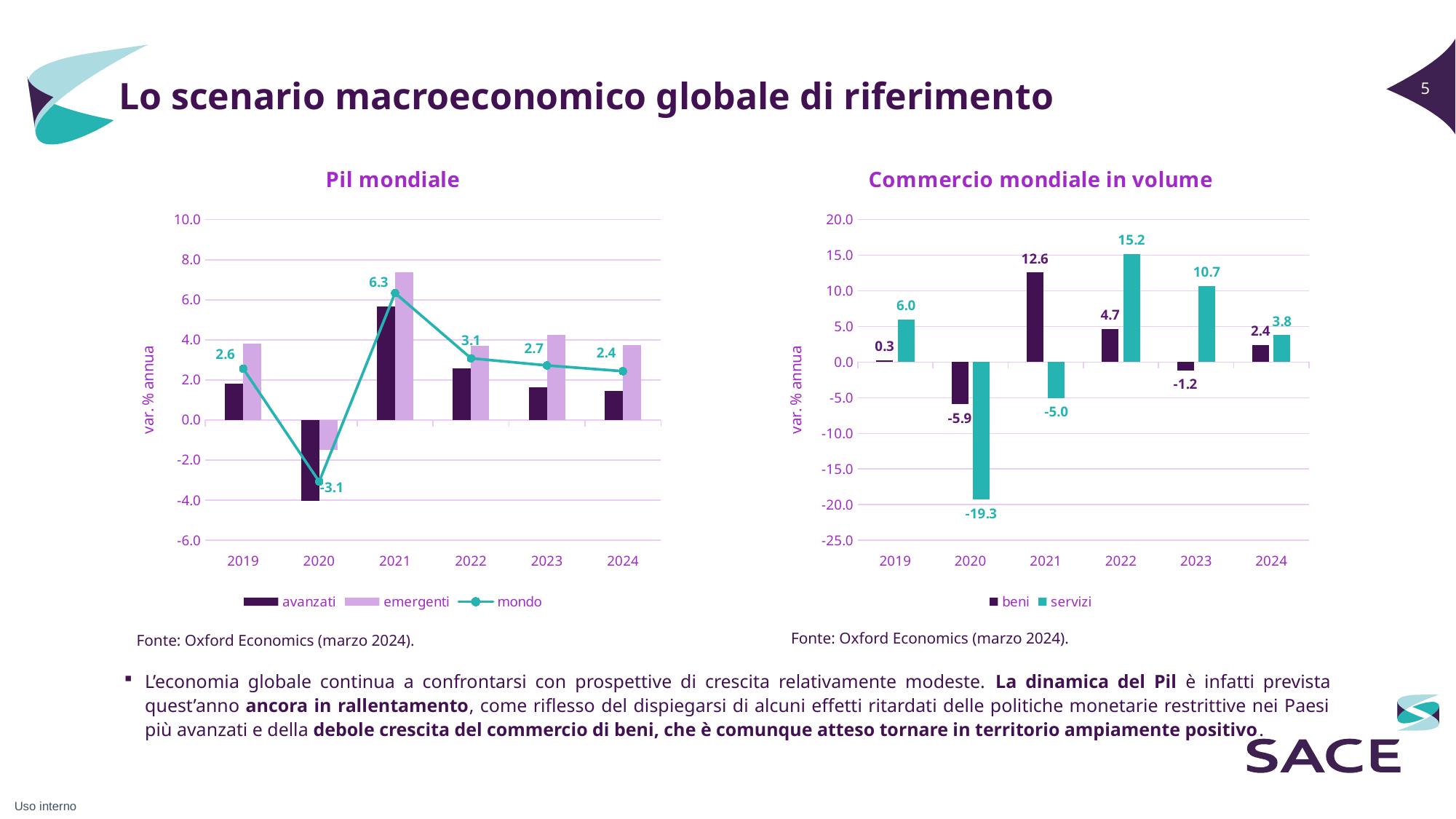
In the 'Commercio mondiale in volume' chart, what is the value of 'beni' for 2021? 12.6 In the 'Commercio mondiale in volume' chart, what is the difference between 'servizi' and 'beni' in 2022? 10.5 In the 'Pil mondiale' chart, how many series does the legend list? 3 In the 'Pil mondiale' chart, what is the value of the 'mondo' line for 2021? 6.3 In the 'Pil mondiale' chart, which year has the highest 'mondo' value? 2021 In the 'Pil mondiale' chart, what is the difference between the 'mondo' values for 2021 and 2022? 3.2 In the 'Commercio mondiale in volume' chart, which year has the highest 'servizi' value? 2022 In the 'Pil mondiale' chart, what is the value of the 'mondo' line for 2020? -3.1 In the 'Commercio mondiale in volume' chart, what is the value of 'servizi' for 2020? -19.3 How many years are shown on the x axis of the 'Commercio mondiale in volume' chart? 6 In the 'Pil mondiale' chart, is the 'emergenti' bar for 2021 greater or less than 6.0? greater In the 'Commercio mondiale in volume' chart, which is larger in 2023: 'beni' or 'servizi'? servizi